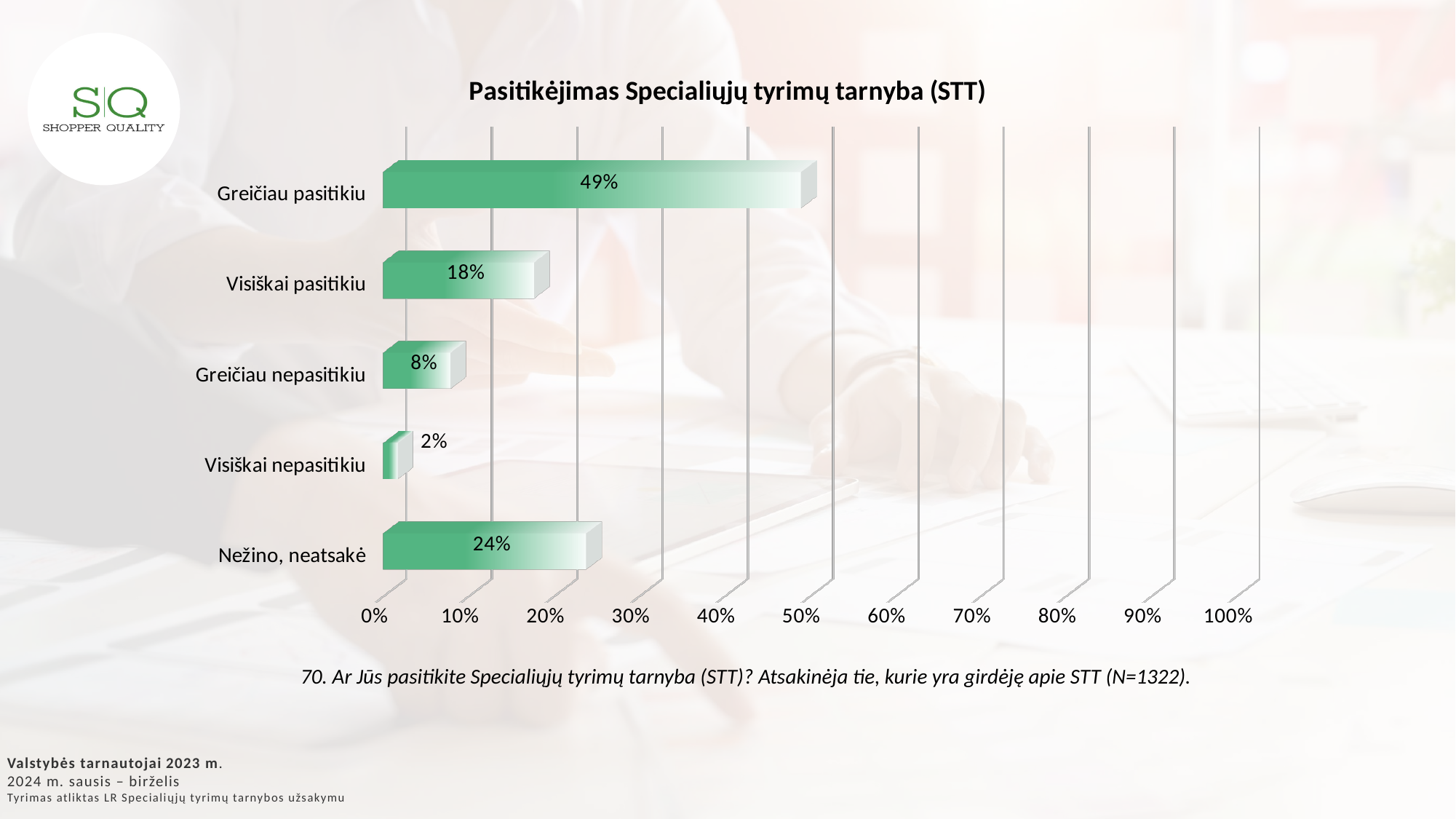
Which category has the highest value? Greičiau pasitikiu Which category has the lowest value? Visiškai nepasitikiu Is the value for "Greičiau nepasitikiu" greater or less than 10%? less What is the value for "Visiškai nepasitikiu"? 2% What kind of chart is shown on the slide? bar chart What is the title of the chart? Pasitikėjimas Specialiųjų tyrimų tarnyba (STT) Which is larger, "Nežino, neatsakė" or "Visiškai pasitikiu"? Nežino, neatsakė What is the value for "Visiškai pasitikiu"? 18% What is the value for "Greičiau pasitikiu"? 49% What is the value for "Nežino, neatsakė"? 24% What is the difference between "Greičiau pasitikiu" and "Visiškai pasitikiu"? 31% How many categories are shown in the chart? 5